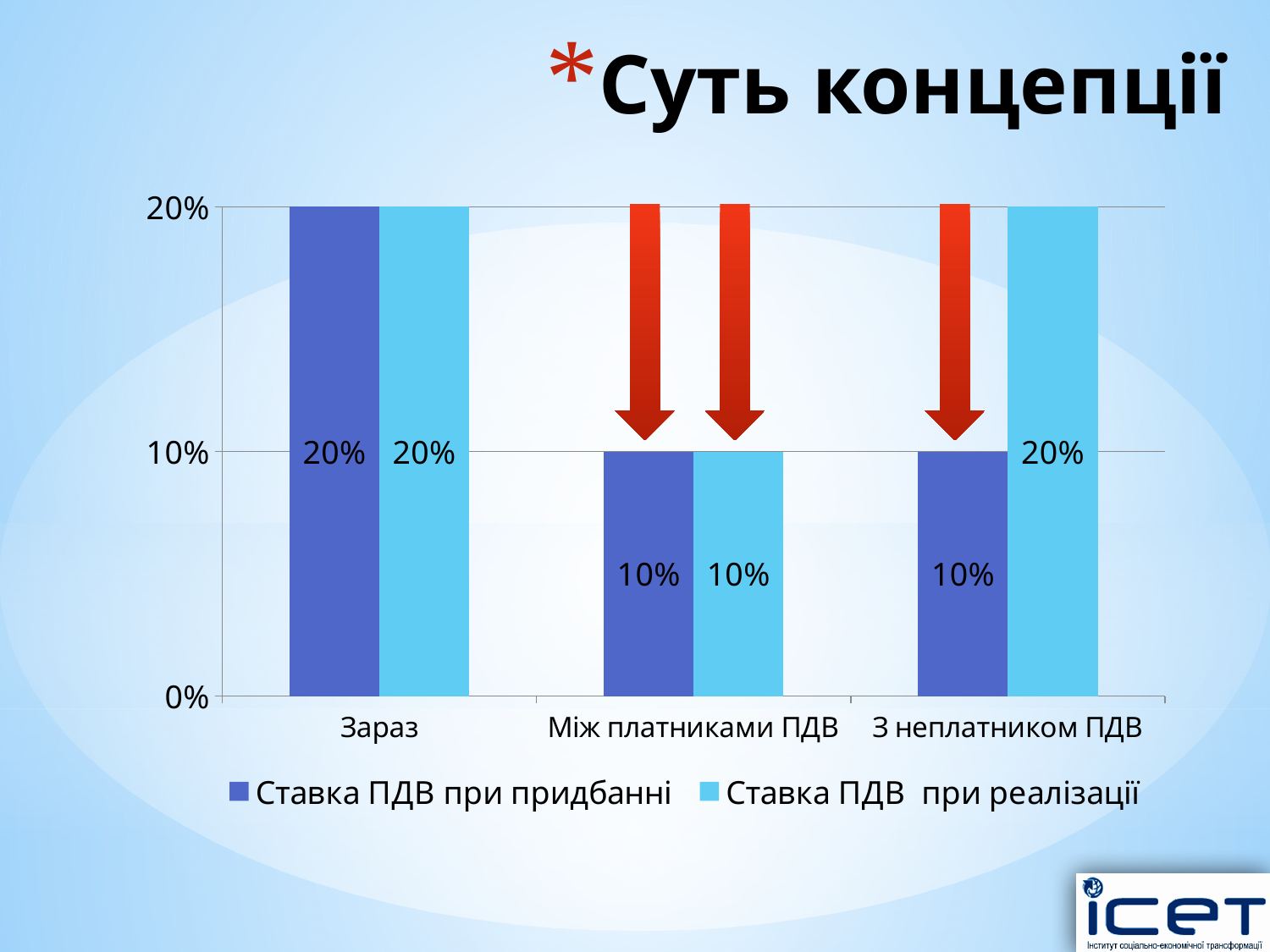
For 'З неплатником ПДВ', which is larger: 'Ставка ПДВ при придбанні' or 'Ставка ПДВ при реалізації'? Ставка ПДВ при реалізації What is the value of 'Ставка ПДВ при придбанні' for 'З неплатником ПДВ'? 10% What kind of chart is shown on the slide? Bar chart What is the value of 'Ставка ПДВ при придбанні' for 'Зараз'? 20% Which category has the lowest value for 'Ставка ПДВ при реалізації'? Між платниками ПДВ What is the value of 'Ставка ПДВ при реалізації' for 'З неплатником ПДВ'? 20% What is the difference between 'Ставка ПДВ при реалізації' and 'Ставка ПДВ при придбанні' for 'З неплатником ПДВ'? 10% What is the difference between 'Ставка ПДВ при придбанні' for 'Зараз' and for 'Між платниками ПДВ'? 10% What is the title of the slide? Суть концепції How many categories are shown on the x axis? 3 What is the value of 'Ставка ПДВ при реалізації' for 'Між платниками ПДВ'? 10% How many series does the legend list? 2